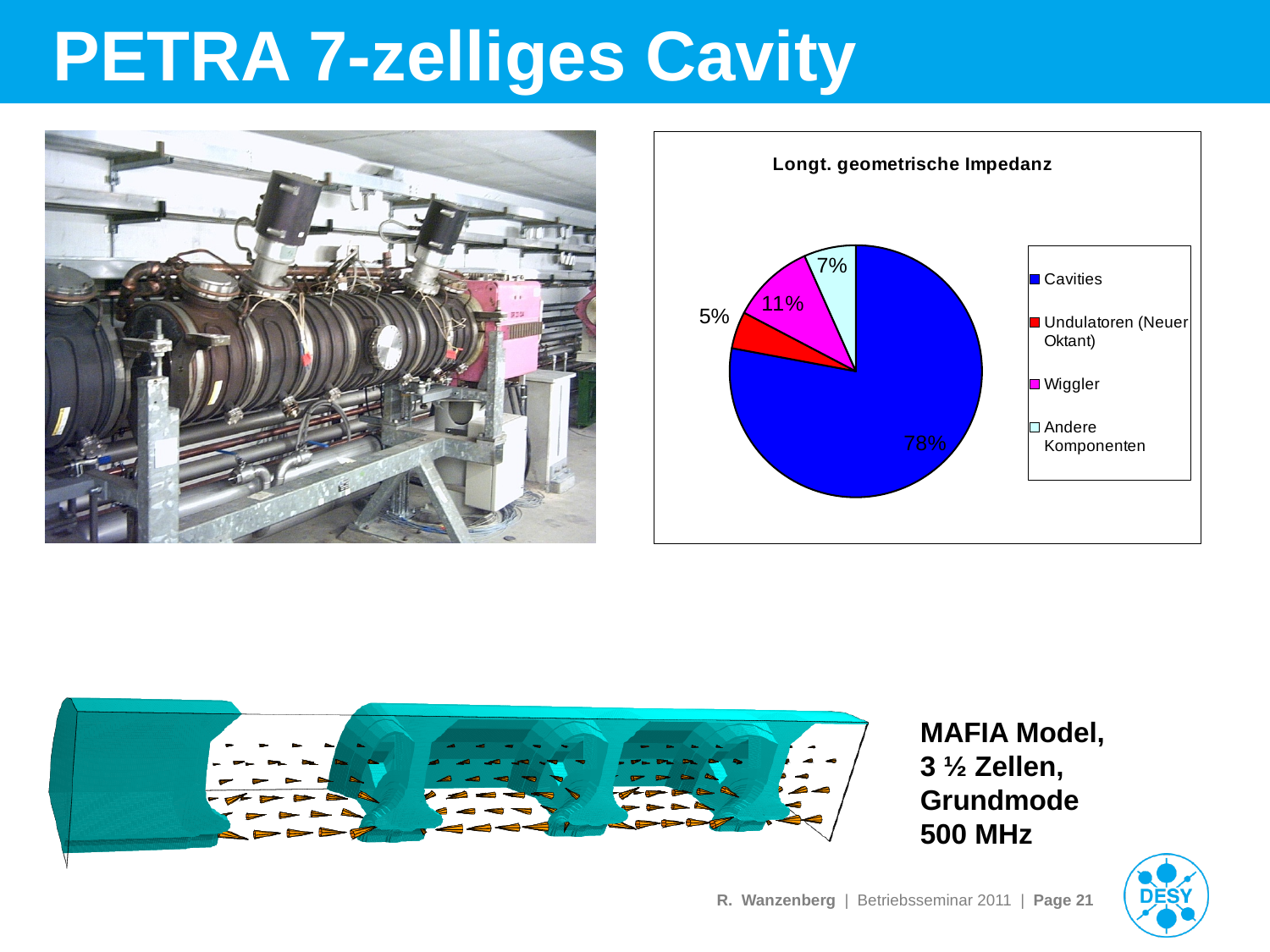
What is the value shown for Andere Komponenten? 7% What is the difference between the Cavities share and the Wiggler share? 67% Which is larger, the share for Wiggler or the share for Andere Komponenten? Wiggler Which category has the largest slice of the pie? Cavities What type of chart is shown on the slide? pie chart What share of the pie does Cavities account for? 78% What is the title of the chart? Longt. geometrische Impedanz Which category has the smallest slice of the pie? Undulatoren (Neuer Oktant) What share of the pie does Wiggler account for? 11% How many slices does the pie chart have? 4 What is the value shown for Undulatoren (Neuer Oktant)? 5% What colour is the Wiggler slice in the pie chart? magenta